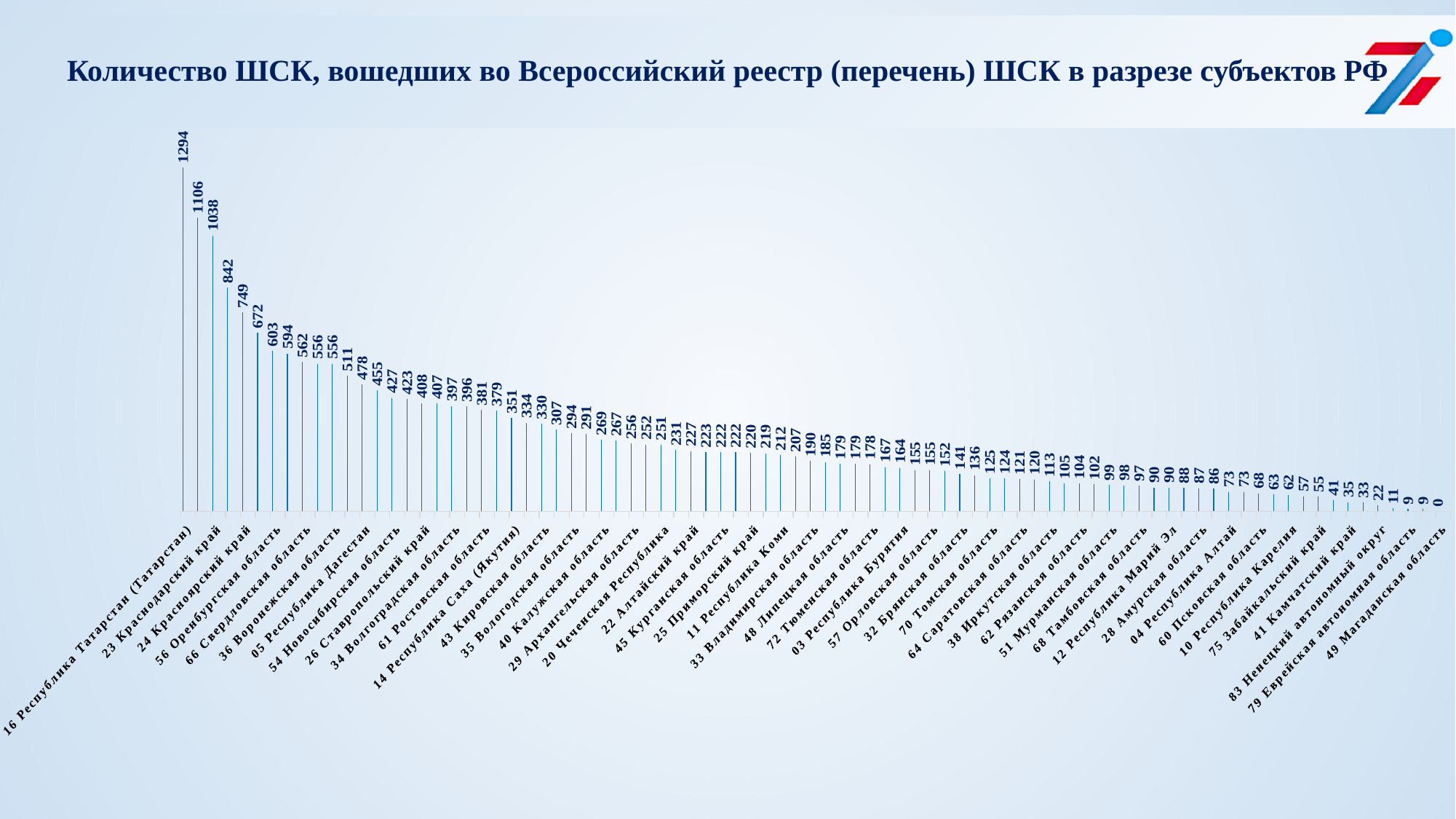
What is the value for 16 Республика Татарстан (Татарстан)? 1294 What is the value for 23 Краснодарский край? 1038 What is the value of the tallest bar on the chart? 1294 What is the value for 24 Красноярский край? 749 What is the value for 49 Магаданская область? 0 What is the title of the chart? Количество ШСК, вошедших во Всероссийский реестр (перечень) ШСК в разрезе субъектов РФ Which is larger, the value for 23 Краснодарский край or the value for 24 Красноярский край? 23 Краснодарский край Do the values rise or fall from left to right along the x axis? fall What kind of chart is shown on the slide? bar chart Which region has the lowest value on the chart? 49 Магаданская область Which region has the highest value on the chart? 16 Республика Татарстан (Татарстан) What is the difference between the values for 16 Республика Татарстан (Татарстан) and 23 Краснодарский край? 256